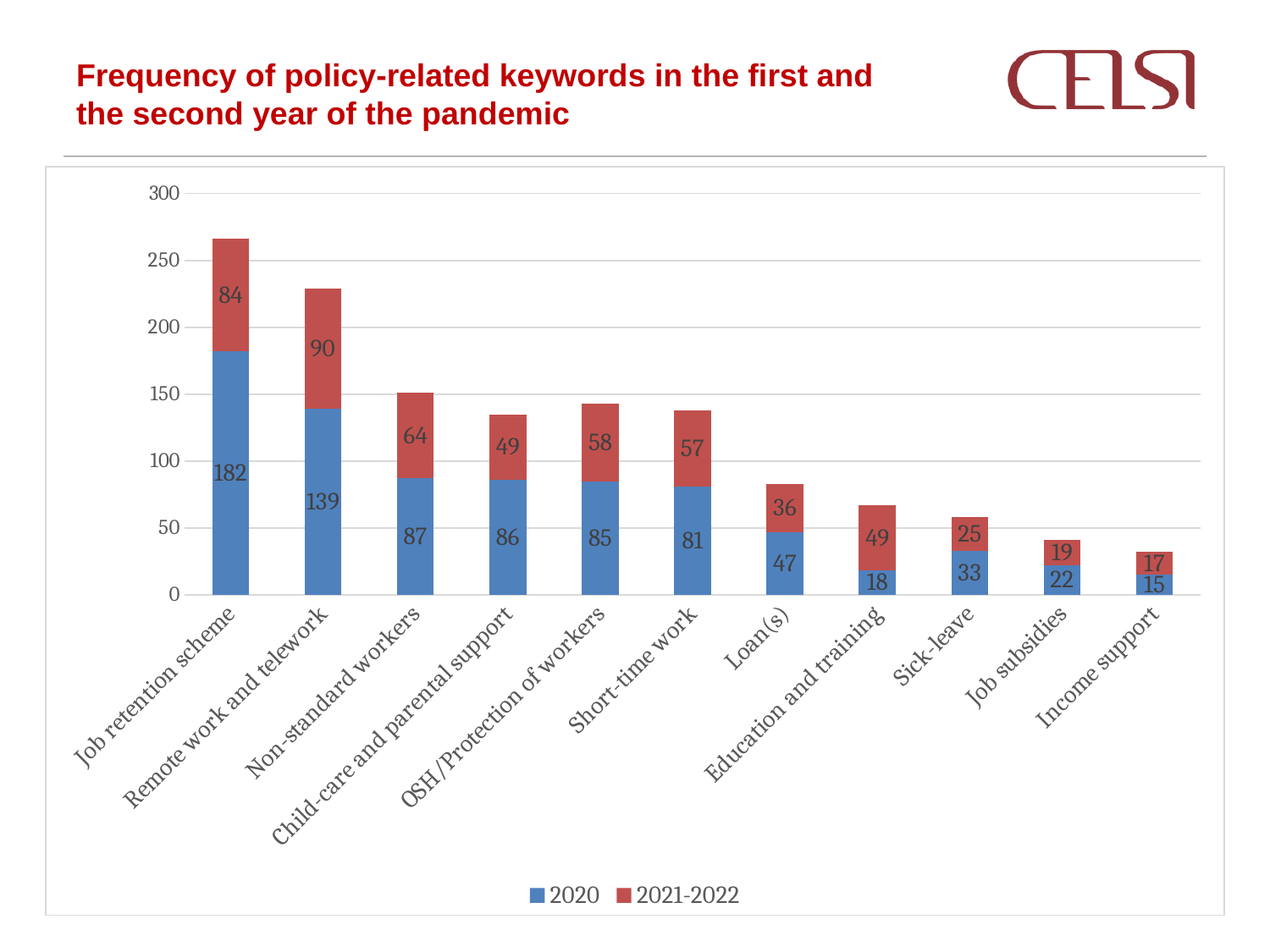
What is the difference between the 2020 values for Job retention scheme and Remote work and telework? 43 Which is larger: the 2021-2022 value for Non-standard workers or the 2021-2022 value for Short-time work? Non-standard workers What is the total of the stacked bar for Sick-leave? 58 What is the total of the stacked bar for Job retention scheme? 266 What is the 2021-2022 value for Remote work and telework? 90 Which category has the highest 2020 value? Job retention scheme What kind of chart is shown on the slide? Stacked bar chart How many series does the legend list? 2 How many categories are shown on the x axis? 11 What is the 2020 value for Job retention scheme? 182 Which category has the lowest 2020 value? Income support What is the 2020 value for Loan(s)? 47